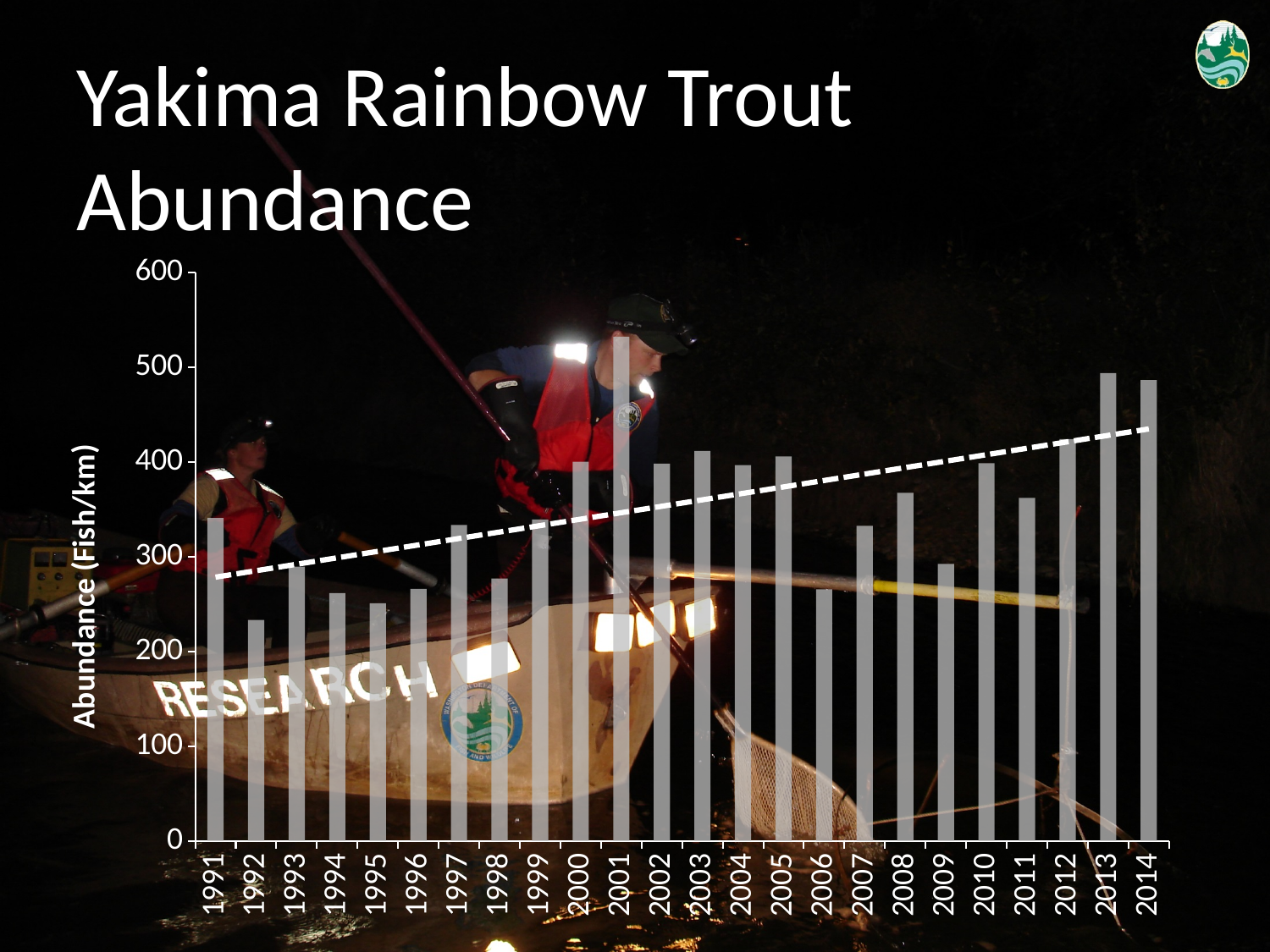
According to the dashed trend line, does abundance generally rise or fall from 1991 to 2014? rise Is the abundance value for 1992 greater or less than 300? less What is the title of the slide containing the chart? Yakima Rainbow Trout Abundance Which year has the larger abundance, 1999 or 1992? 1999 Is the abundance value for 1999 greater or less than 500? less Which year has the lowest abundance in the chart? 1992 What is the label on the y axis of the chart? Abundance (Fish/km) Is the abundance value for 2014 greater or less than 400? greater How many years are plotted along the x axis of the chart? 24 What kind of chart is shown on the slide? bar chart